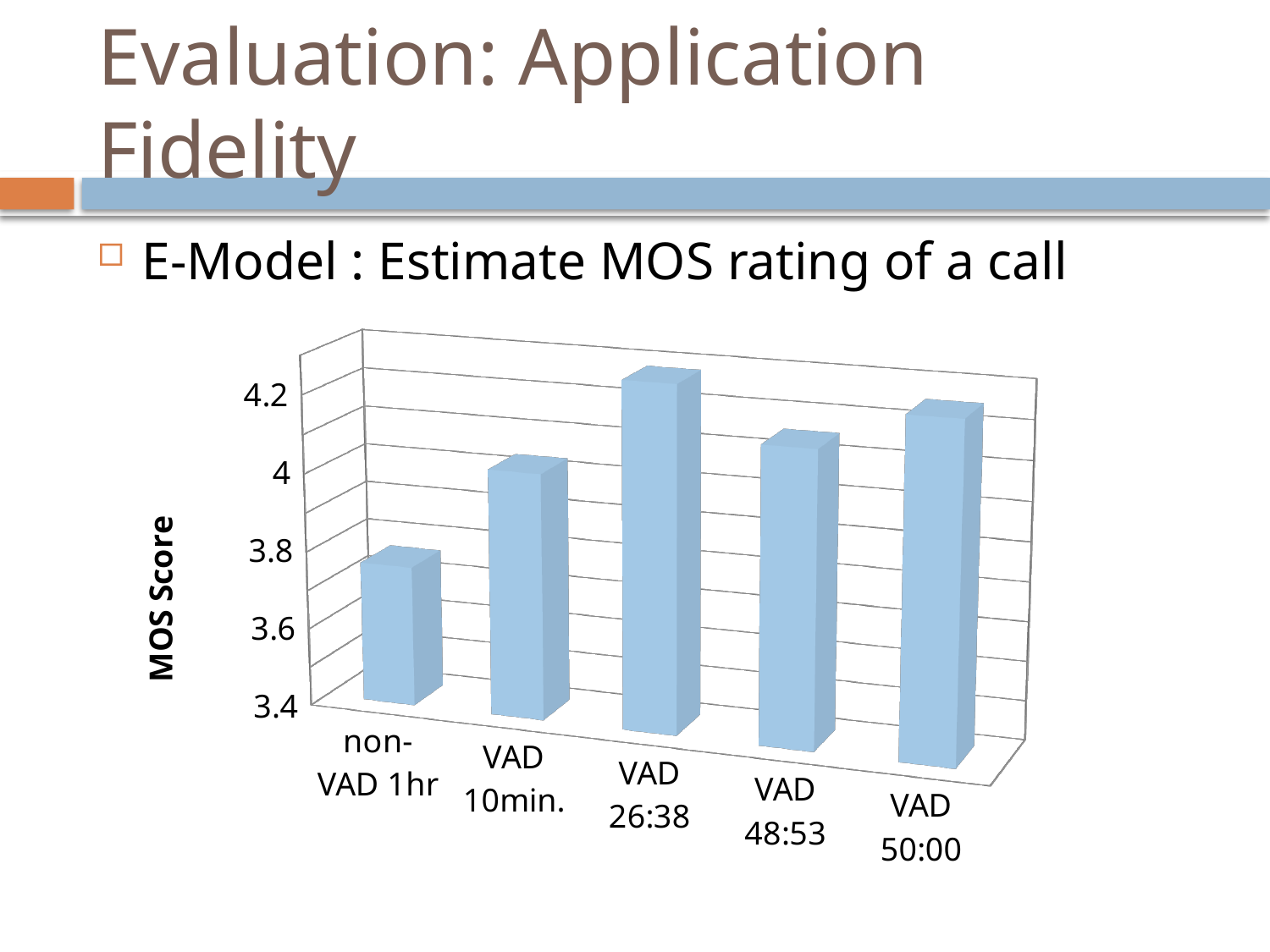
Is the MOS Score for non-VAD 1hr greater or less than 4? less Which has a higher MOS Score, VAD 26:38 or VAD 50:00? VAD 26:38 Which has a higher MOS Score, non-VAD 1hr or VAD 10min.? VAD 10min. Is the MOS Score for VAD 48:53 greater or less than 3.8? greater Which category has the highest MOS Score? VAD 26:38 What kind of chart is shown on the slide? bar chart Which category has the lowest MOS Score? non-VAD 1hr What is the label of the vertical axis of the chart? MOS Score Is the MOS Score for VAD 26:38 greater or less than 4? greater What is the lowest value shown on the vertical axis of the chart? 3.4 How many categories are plotted in the chart? 5